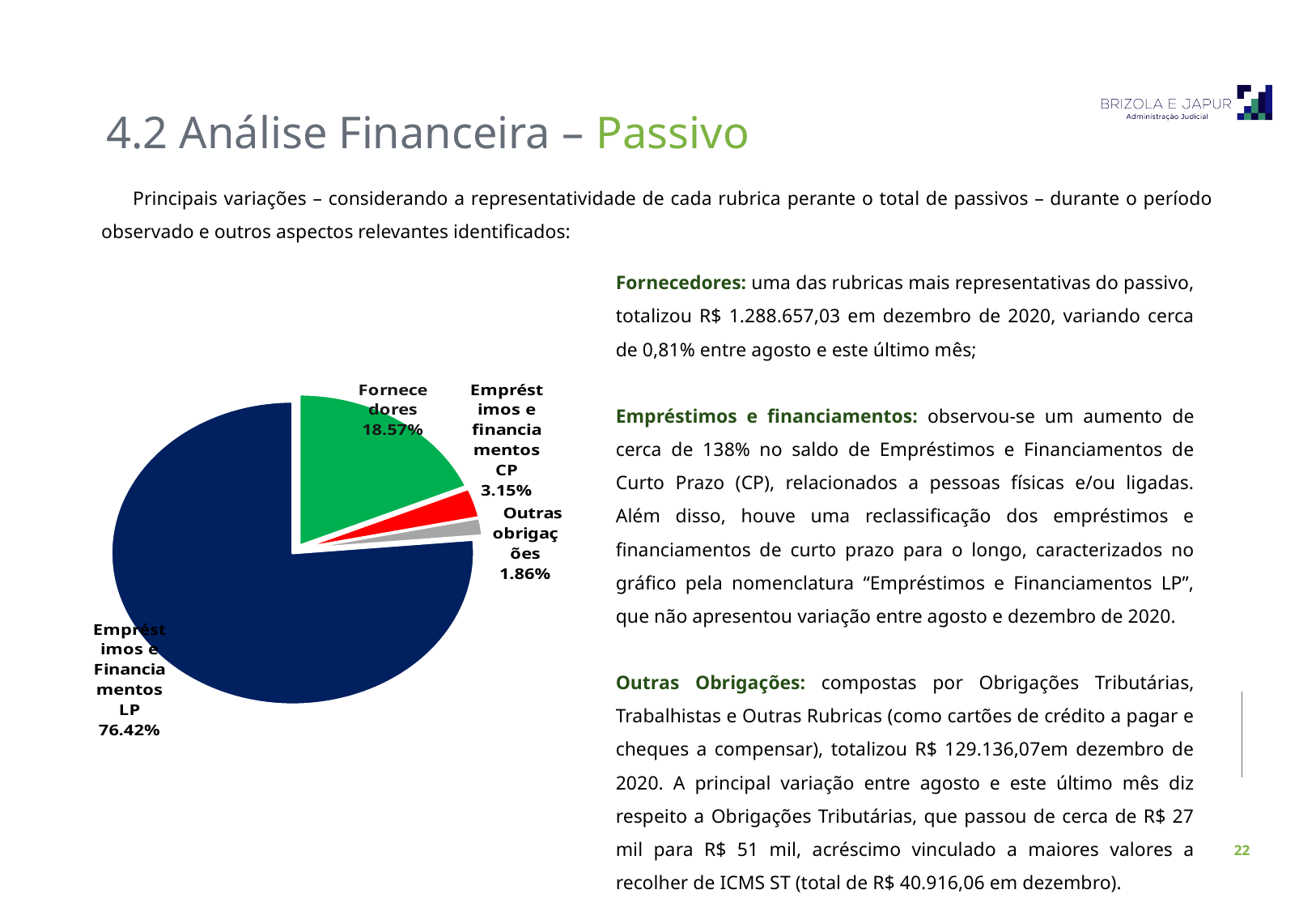
Which slice of the pie chart is the largest? Empréstimos e Financiamentos LP What colour is the Fornecedores slice in the pie chart? green What share of the pie does Fornecedores represent? 18.57% Which slice of the pie chart is the smallest? Outras obrigações What is the difference in percentage points between Empréstimos e Financiamentos LP and Fornecedores? 57.85 What share of the pie does Outras obrigações represent? 1.86% What share of the pie does Empréstimos e Financiamentos LP represent? 76.42% What kind of chart is shown on the slide? pie chart How many slices does the pie chart have? 4 What is the difference in percentage points between Fornecedores and Empréstimos e financiamentos CP? 15.42 Which is larger, the share for Empréstimos e financiamentos CP or the share for Outras obrigações? Empréstimos e financiamentos CP